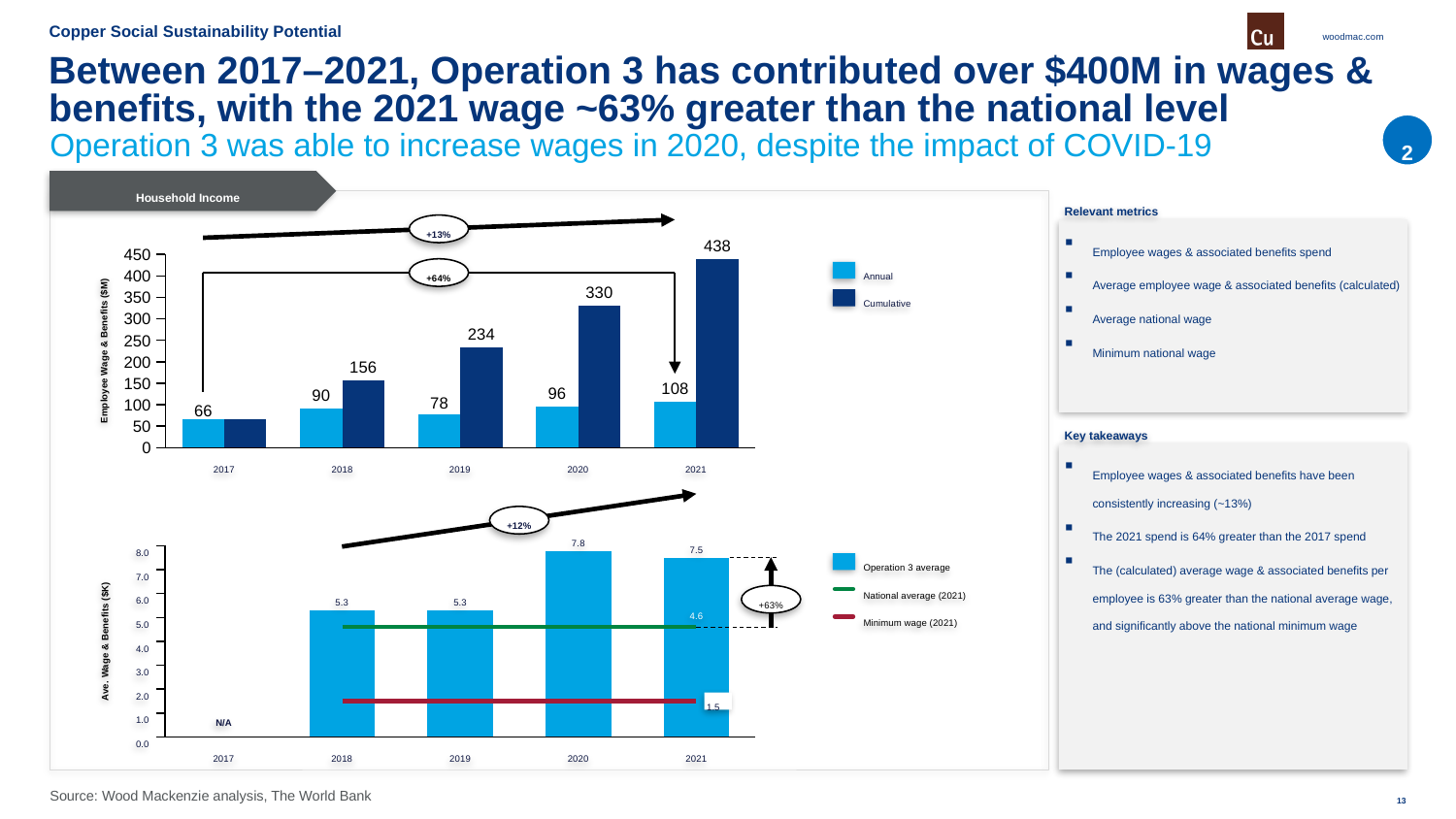
In the bottom chart, what is the National average (2021) value? 4.6 In the top chart, what is the Cumulative value for 2021? 438 In the top chart, which year has the lowest Annual value? 2017 In the top chart, what is the difference between the Annual values for 2021 and 2017? 42 In the bottom chart, what is the Operation 3 average wage & benefits value for 2020? 7.8 How many series does the legend of the top chart list? 2 In the top chart, is the Annual value for 2019 larger or smaller than the Annual value for 2018? smaller In the bottom chart, what is shown for Operation 3 average in 2017? N/A In the top chart, which year has the highest Annual value? 2021 In the top chart, what is the Annual employee wage & benefits value for 2018? 90 What type of chart is the top chart? bar chart In the bottom chart, what is the difference between the Operation 3 average for 2021 and the Minimum wage (2021)? 6.0